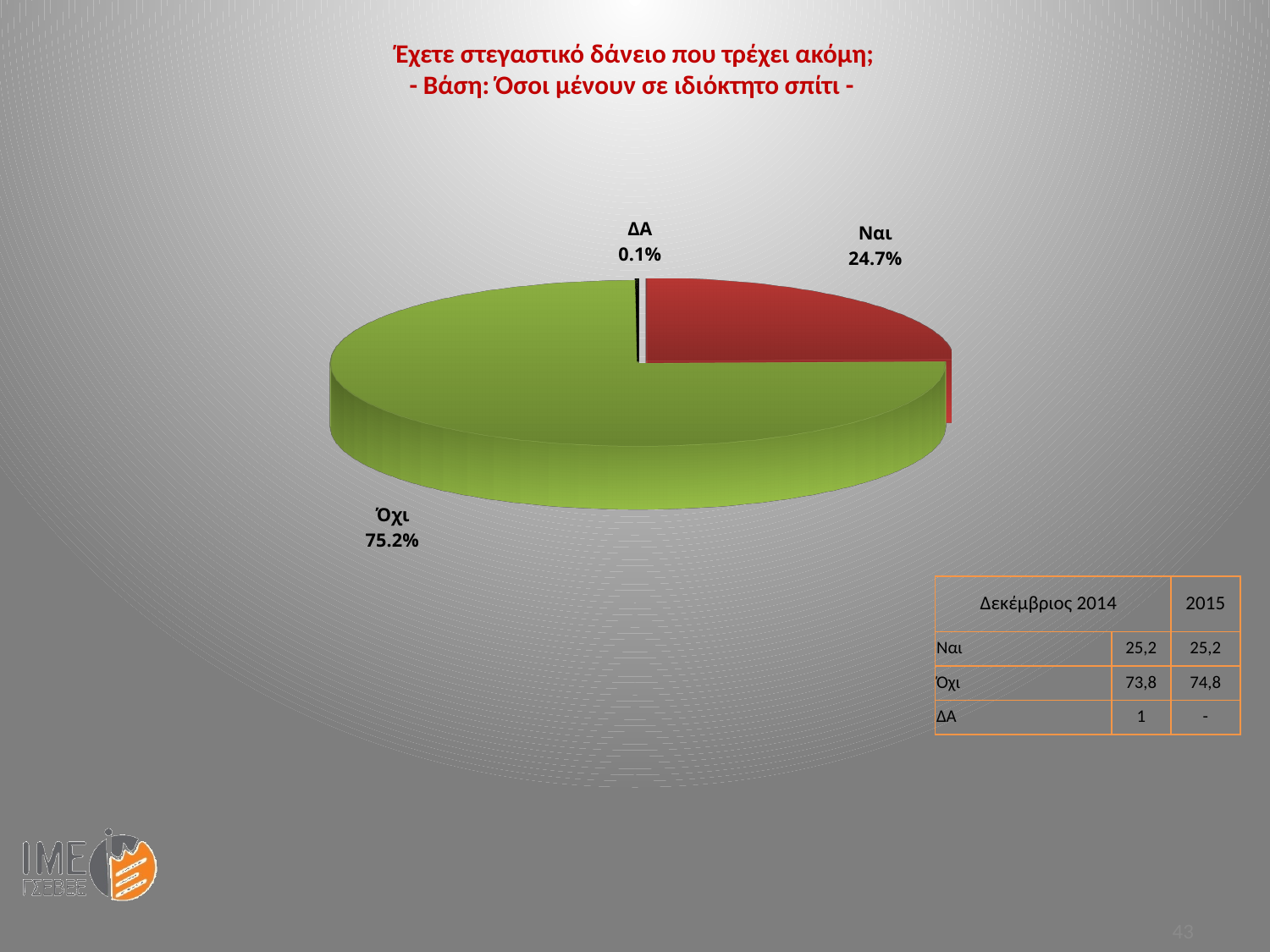
What colour is the "Ναι" slice of the pie chart? Red Which category has the smallest slice in the pie chart? ΔΑ What percentage of the pie chart is labelled "Ναι"? 24.7% What type of chart is shown on the slide? Pie chart What percentage of the pie chart is labelled "ΔΑ"? 0.1% What colour is the "Όχι" slice of the pie chart? Green What is the difference in percentage points between the "Όχι" and "Ναι" slices? 50.5 Is the share of the "Ναι" slice greater or less than 50%? less How many slices does the pie chart have? 3 Which category has the largest slice in the pie chart? Όχι Which slice is larger, "Ναι" or "Όχι"? Όχι What percentage of the pie chart is labelled "Όχι"? 75.2%